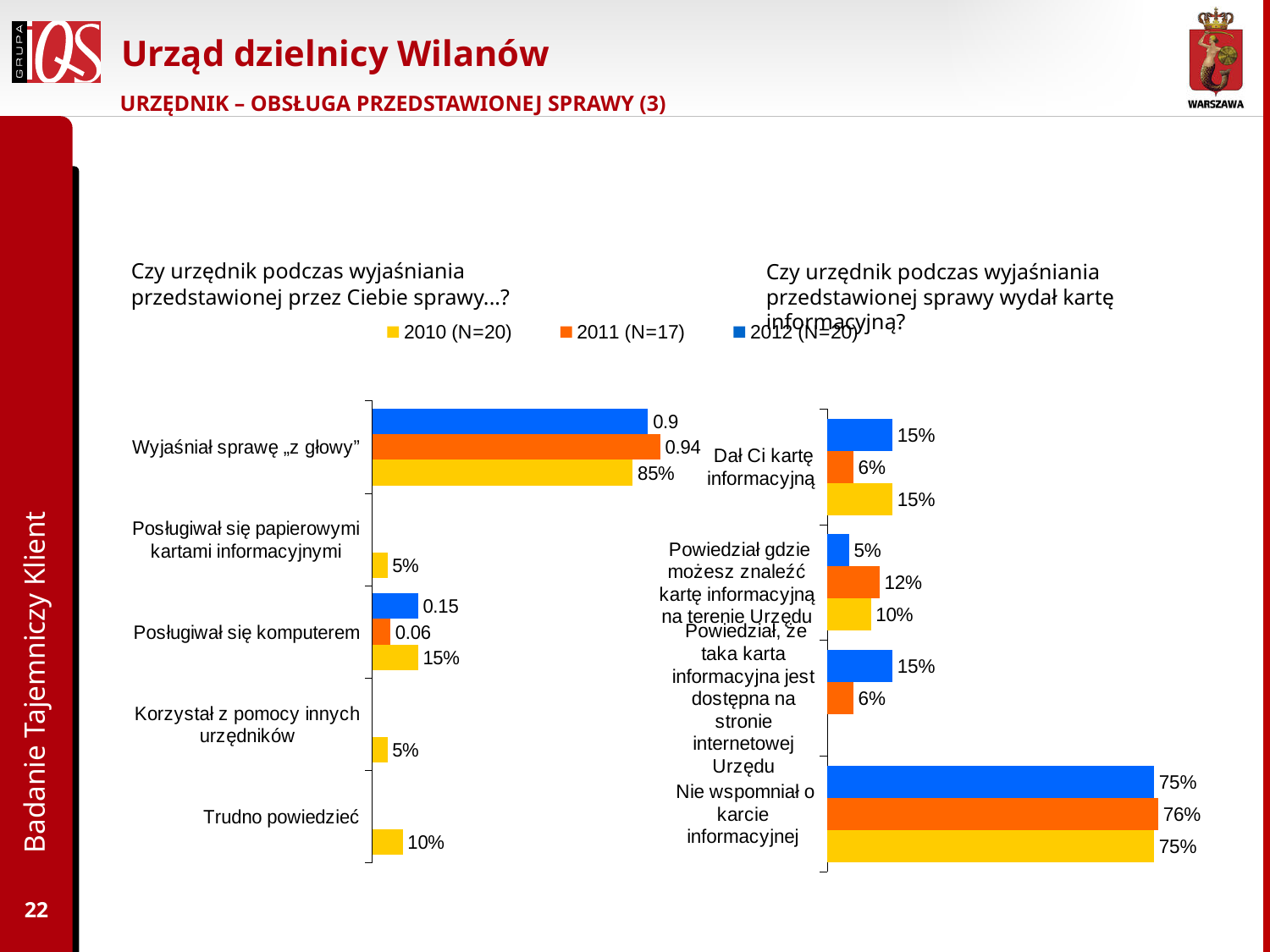
In the right chart, what is the difference between the 2012 (N=20) and 2011 (N=17) values for "Dał Ci kartę informacyjną"? 9% In the left chart, what value is labelled on the 2012 (N=20) bar for "Posługiwał się komputerem"? 0.15 How many series does the legend list? 3 In the right chart, what is the 2011 (N=17) value for "Powiedział gdzie możesz znaleźć kartę informacyjną na terenie Urzędu"? 12% In the left chart, what is the 2010 (N=20) value for "Wyjaśniał sprawę „z głowy”"? 85% In the right chart, what is the 2011 (N=17) value for "Nie wspomniał o karcie informacyjnej"? 76% In the left chart, what is the 2010 (N=20) value for "Trudno powiedzieć"? 10% In the left chart, what value is labelled on the 2011 (N=17) bar for "Wyjaśniał sprawę „z głowy”"? 0.94 What kind of chart is the left chart? Bar chart In the left chart, which category has the highest 2010 (N=20) value? Wyjaśniał sprawę „z głowy” In the right chart, which is larger for "Powiedział gdzie możesz znaleźć kartę informacyjną na terenie Urzędu": the 2011 (N=17) value or the 2012 (N=20) value? 2011 (N=17) In the right chart, which category has the highest 2012 (N=20) value? Nie wspomniał o karcie informacyjnej